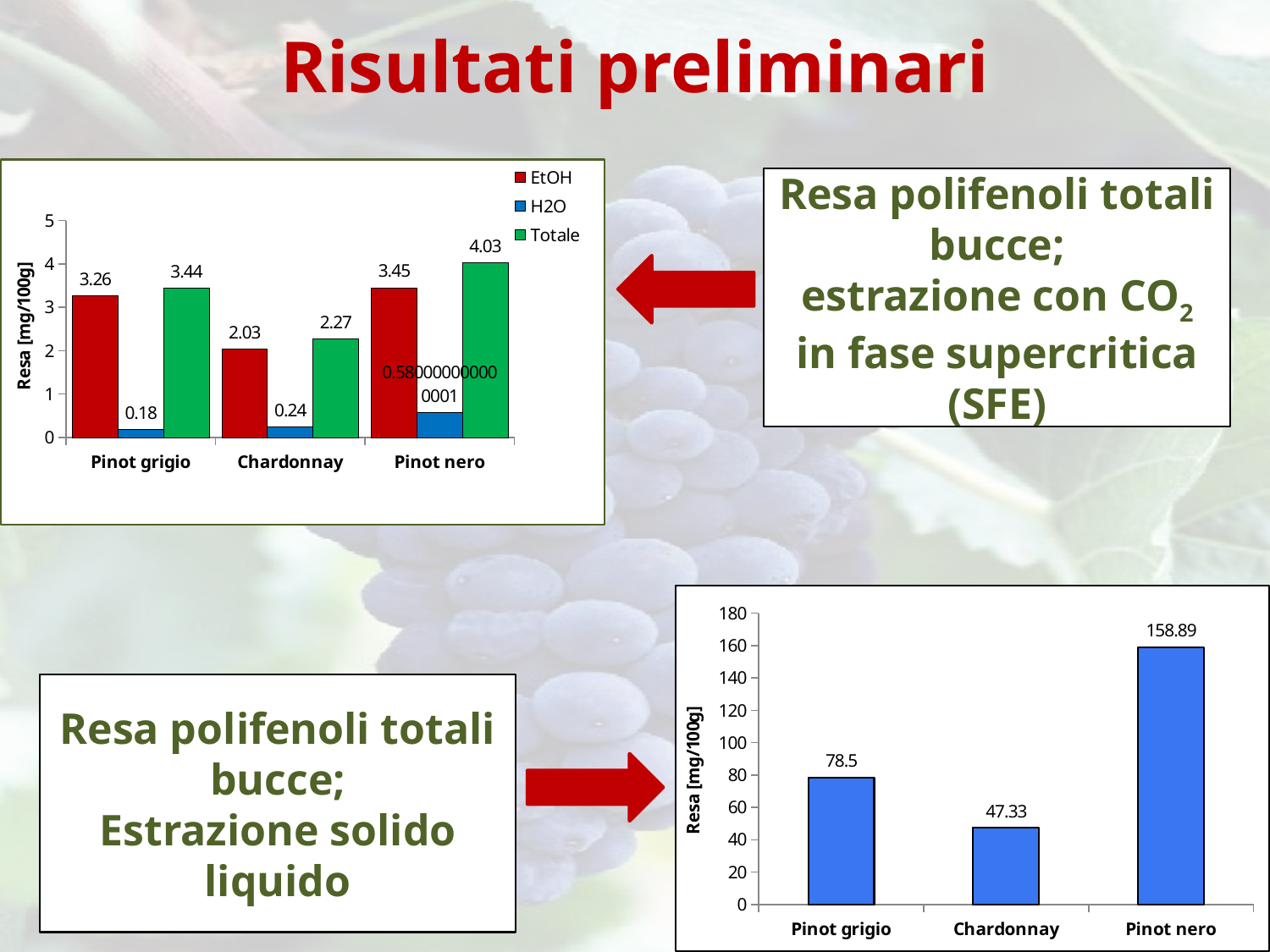
In the top-left chart, what is the EtOH value for Pinot grigio? 3.26 In the top-left chart, what is the Totale value for Pinot nero? 4.03 In the bottom-right chart, which category has the highest value? Pinot nero In the bottom-right chart, what is the value for Pinot nero? 158.89 In the top-left chart, how many series does the legend list? 3 In the bottom-right chart, what is the difference between the values for Pinot grigio and Chardonnay? 31.17 What kind of chart is the bottom-right chart? Bar chart In the bottom-right chart, how many categories are shown on the x axis? 3 In the top-left chart, what is the difference between the Totale values for Pinot nero and Pinot grigio? 0.59 In the top-left chart, what is the H2O value for Chardonnay? 0.24 In the top-left chart, which category has the lowest Totale value? Chardonnay In the top-left chart, is the EtOH value for Chardonnay greater or less than the H2O value for Chardonnay? greater